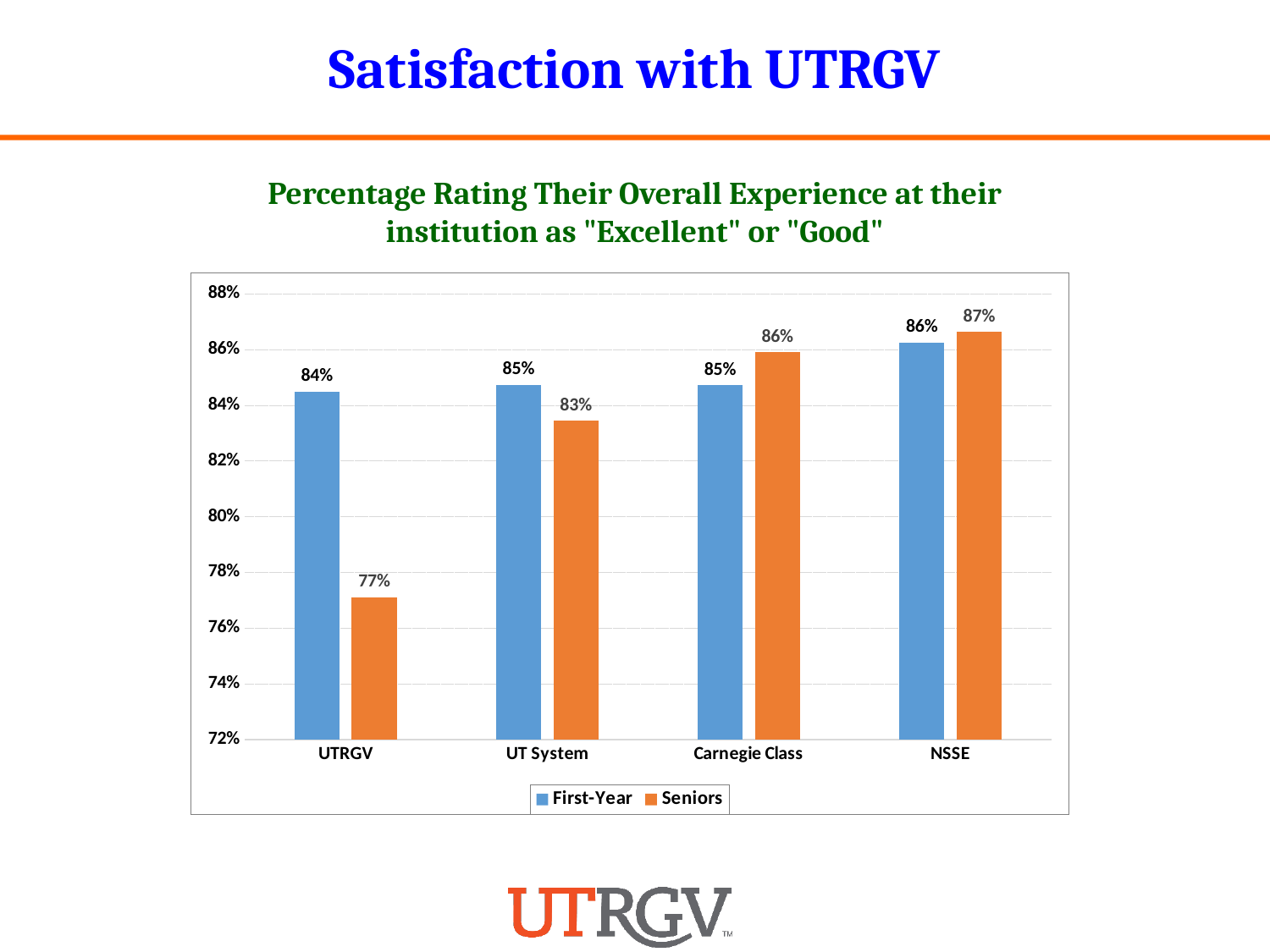
How many series does the legend list? 2 What is the First-Year value for UTRGV? 84% For Carnegie Class, which is larger: the First-Year value or the Seniors value? Seniors What is the Seniors value for NSSE? 87% What kind of chart is shown on the slide? Bar chart How many categories are shown on the x axis? 4 Do the Seniors values rise or fall from UTRGV to NSSE along the x axis? Rise Which category has the lowest Seniors value? UTRGV What is the Seniors value for UT System? 83% Is the Seniors value for UTRGV greater or less than 80%? less What is the difference between the First-Year and Seniors values for UTRGV? 7 percentage points Which category has the highest First-Year value? NSSE